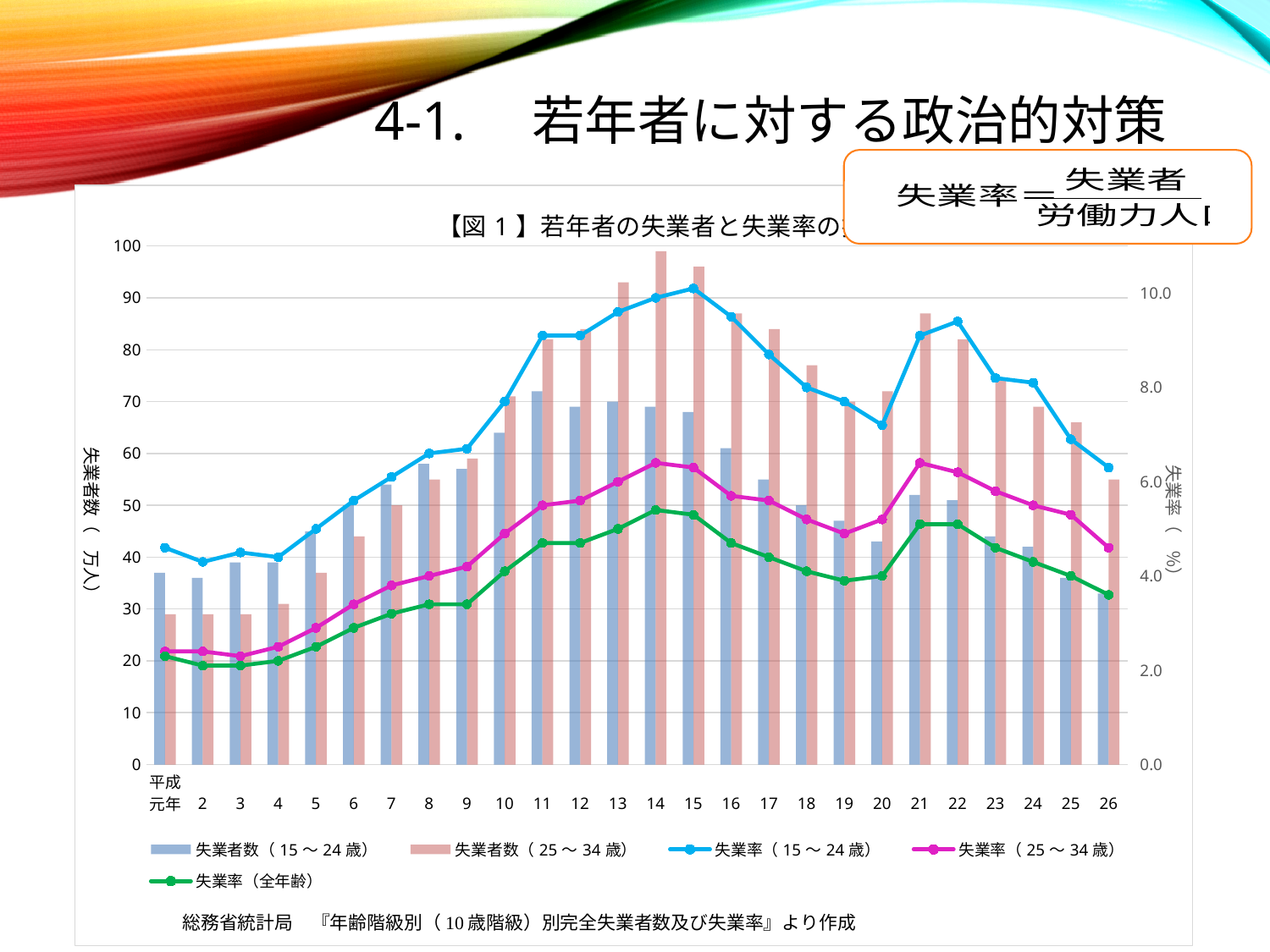
In which year is the 失業者数（25～34歳） bar highest? 14 How many series does the legend list? 5 Is the value of 失業者数（15～24歳） in year 11 greater or less than 60? greater Is the 失業率（全年齢） value in year 14 greater or less than 4.0? greater What colour is the 失業率（全年齢） line? Green Is the 失業率（15～24歳） value in year 26 greater or less than 8.0? less How many years (categories) are shown along the x axis? 26 Does the 失業率（15～24歳） line rise or fall from 平成元年 to year 14? rise In year 26, which is larger: 失業者数（15～24歳） or 失業者数（25～34歳）? 失業者数（25～34歳） What kind of chart is this? Combination bar and line chart In year 14, which is higher: 失業率（15～24歳） or 失業率（全年齢）? 失業率（15～24歳）